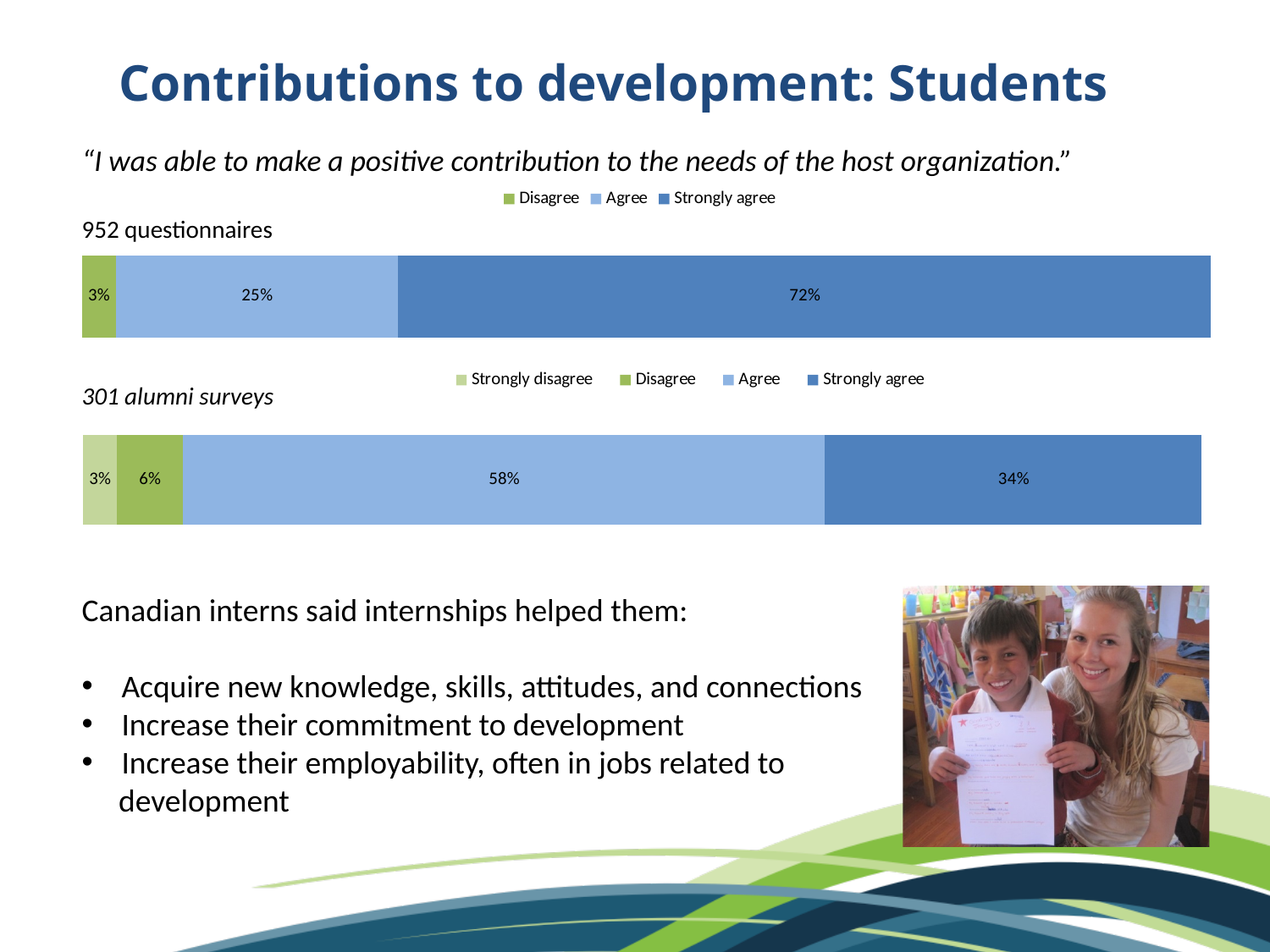
In the bottom chart (301 alumni surveys), what is the combined percentage of Agree and Strongly agree? 92% Which is larger: the Strongly agree share in the top chart (952 questionnaires) or the Strongly agree share in the bottom chart (301 alumni surveys)? Top chart (952 questionnaires) In the bottom chart (301 alumni surveys), what is the difference between the Agree and Strongly agree percentages? 24% In the bottom chart (301 alumni surveys), what percentage of respondents chose Strongly disagree? 3% In the top chart (952 questionnaires), what percentage of respondents chose Agree? 25% In the top chart (952 questionnaires), which response category has the smallest share? Disagree In the bottom chart (301 alumni surveys), what percentage of respondents chose Agree? 58% In the bottom chart (301 alumni surveys), which response category has the largest share? Agree In the top chart (952 questionnaires), what percentage of respondents chose Strongly agree? 72% How many series does the legend of the top chart (952 questionnaires) list? 3 What kind of chart is used for the 952 questionnaires data? Stacked bar chart How many series does the legend of the bottom chart (301 alumni surveys) list? 4